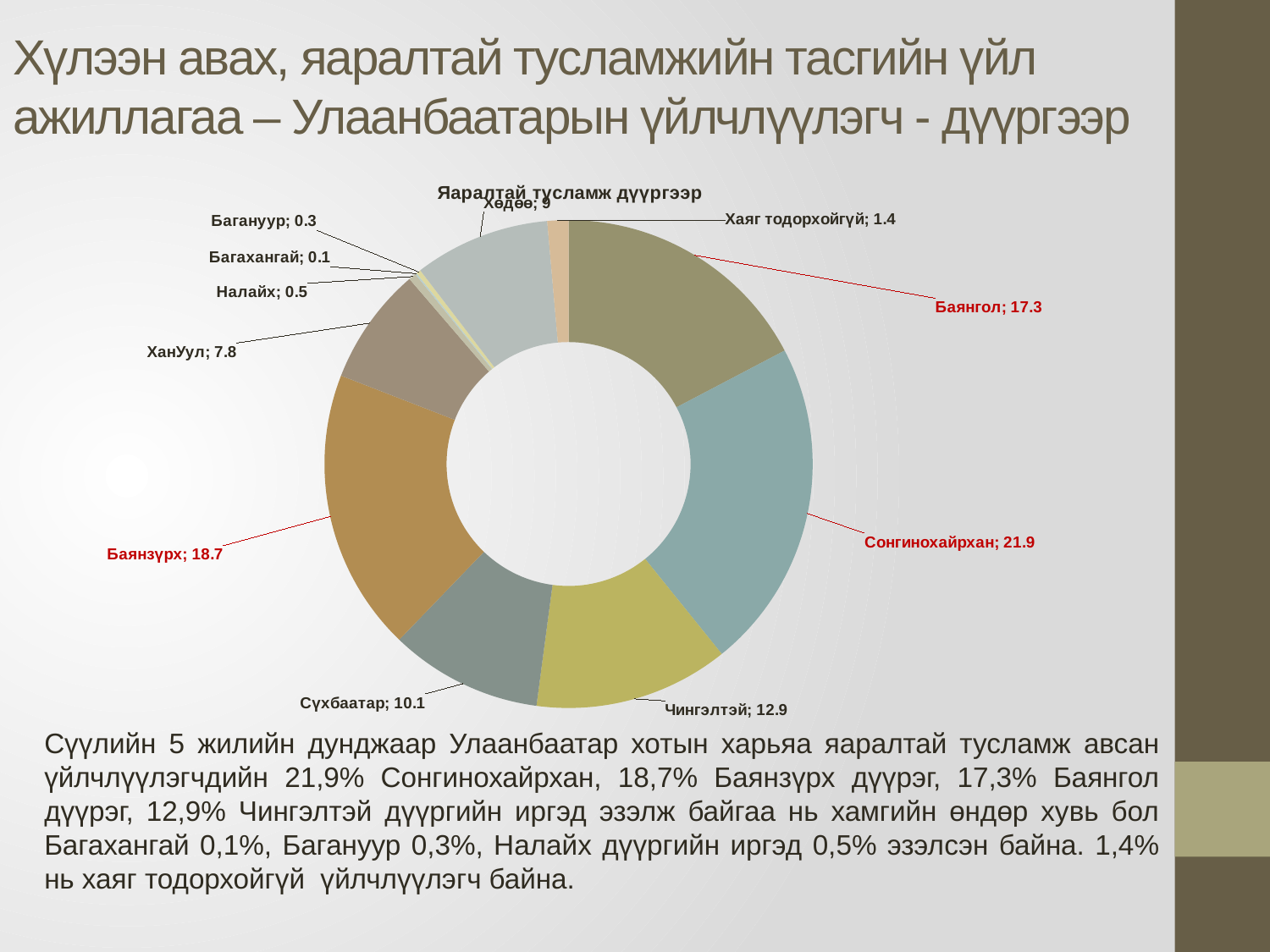
What is the value for Сонгинохайрхан in the chart? 21.9 Which is larger, the value for Баянгол or the value for Чингэлтэй? Баянгол What is the value for Чингэлтэй in the chart? 12.9 What is the value for ХанУул in the chart? 7.8 What kind of chart is shown on the slide? Doughnut (pie) chart What is the difference between the values for Сонгинохайрхан and Баянгол? 4.6 What is the difference between the values for Баянзүрх and Сүхбаатар? 8.6 Which category has the lowest value in the chart? Багахангай How many categories are shown in the chart? 11 What is the title of the chart? Яаралтай тусламж дүүргээр What is the value for Баянзүрх in the chart? 18.7 Which category has the highest value in the chart? Сонгинохайрхан